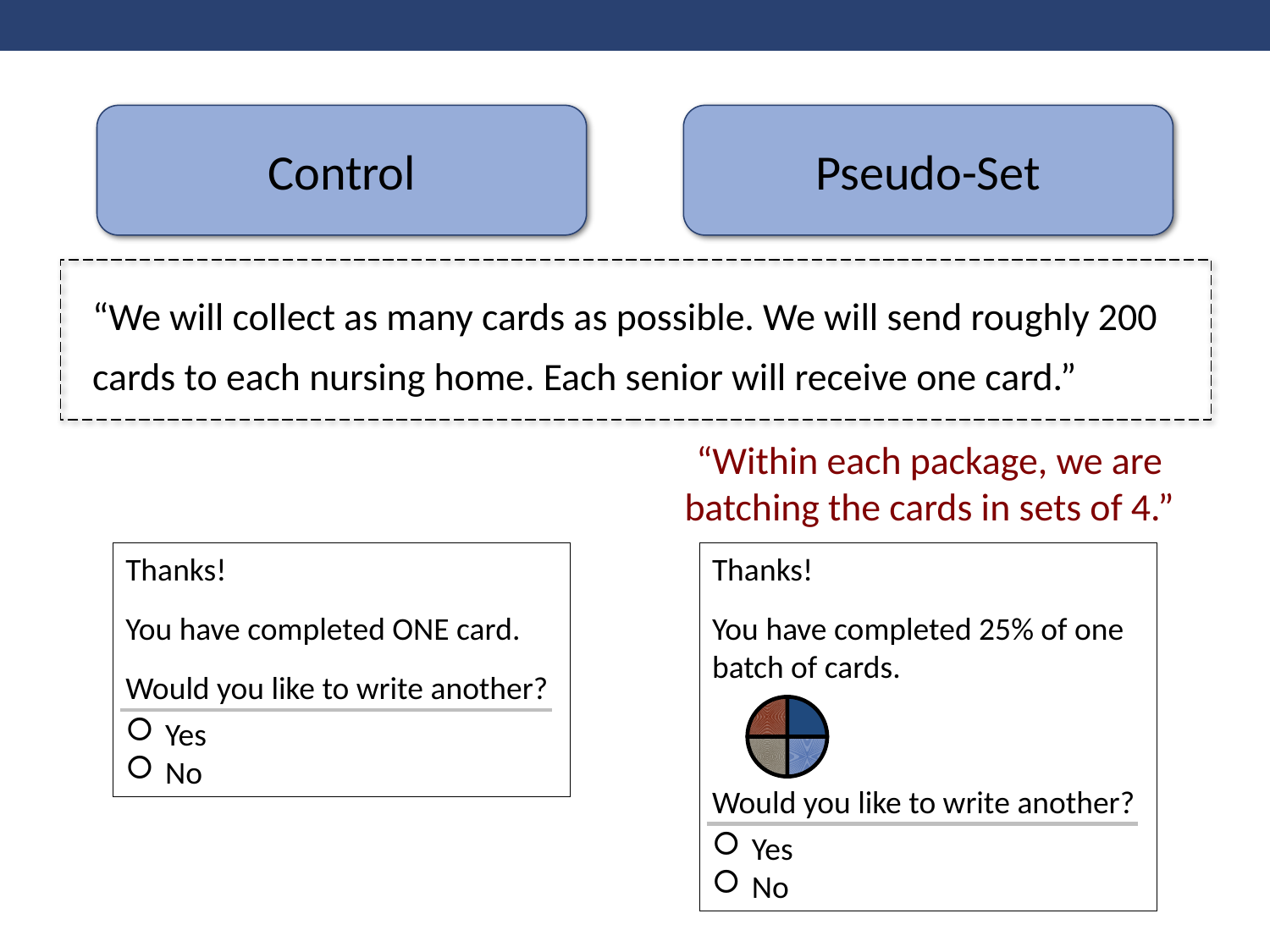
How many slices of the pie chart in the Pseudo-Set box are filled solid dark blue? 1 What kind of chart is shown in the Pseudo-Set box on the right of the slide? pie chart According to the text above the pie chart in the Pseudo-Set box, what share of one batch of cards has been completed? 25% How many slices does the pie chart in the Pseudo-Set box have? 4 Does the pie chart in the Pseudo-Set box have a legend? No